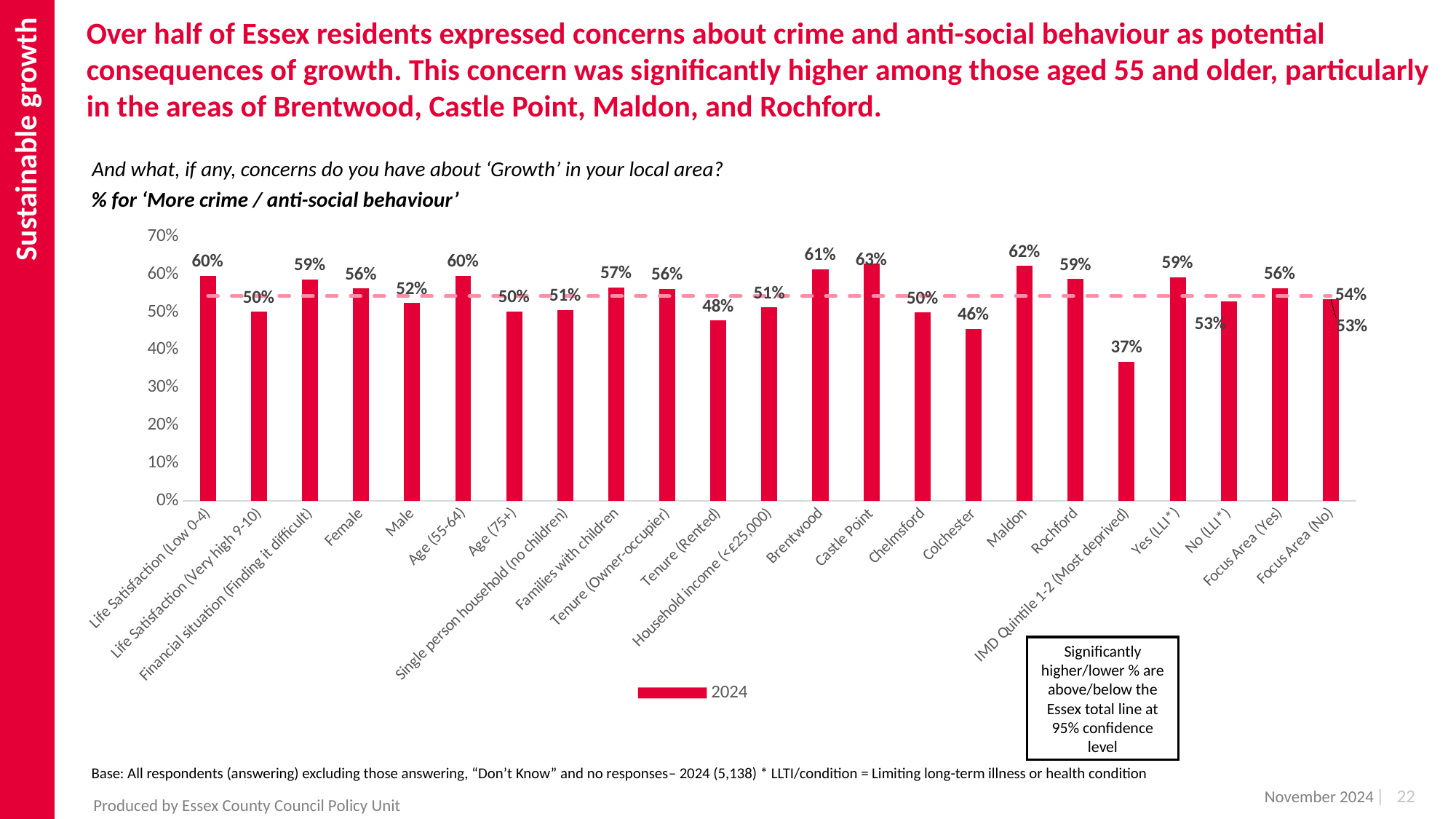
What is the value for IMD Quintile 1-2 (Most deprived)? 37% What is the difference between the values for Maldon and Chelmsford? 12% Which category has the lowest value? IMD Quintile 1-2 (Most deprived) How many series does the legend list? 1 What is the value for Castle Point? 63% Is the value for Brentwood greater or less than 50%? greater Which category has the highest value? Castle Point What is the value for Tenure (Rented)? 48% What is the value for Colchester? 46% What kind of chart is shown on the slide? Bar chart What is the legend entry for the bars? 2024 Which is larger, the value for Female or the value for Male? Female